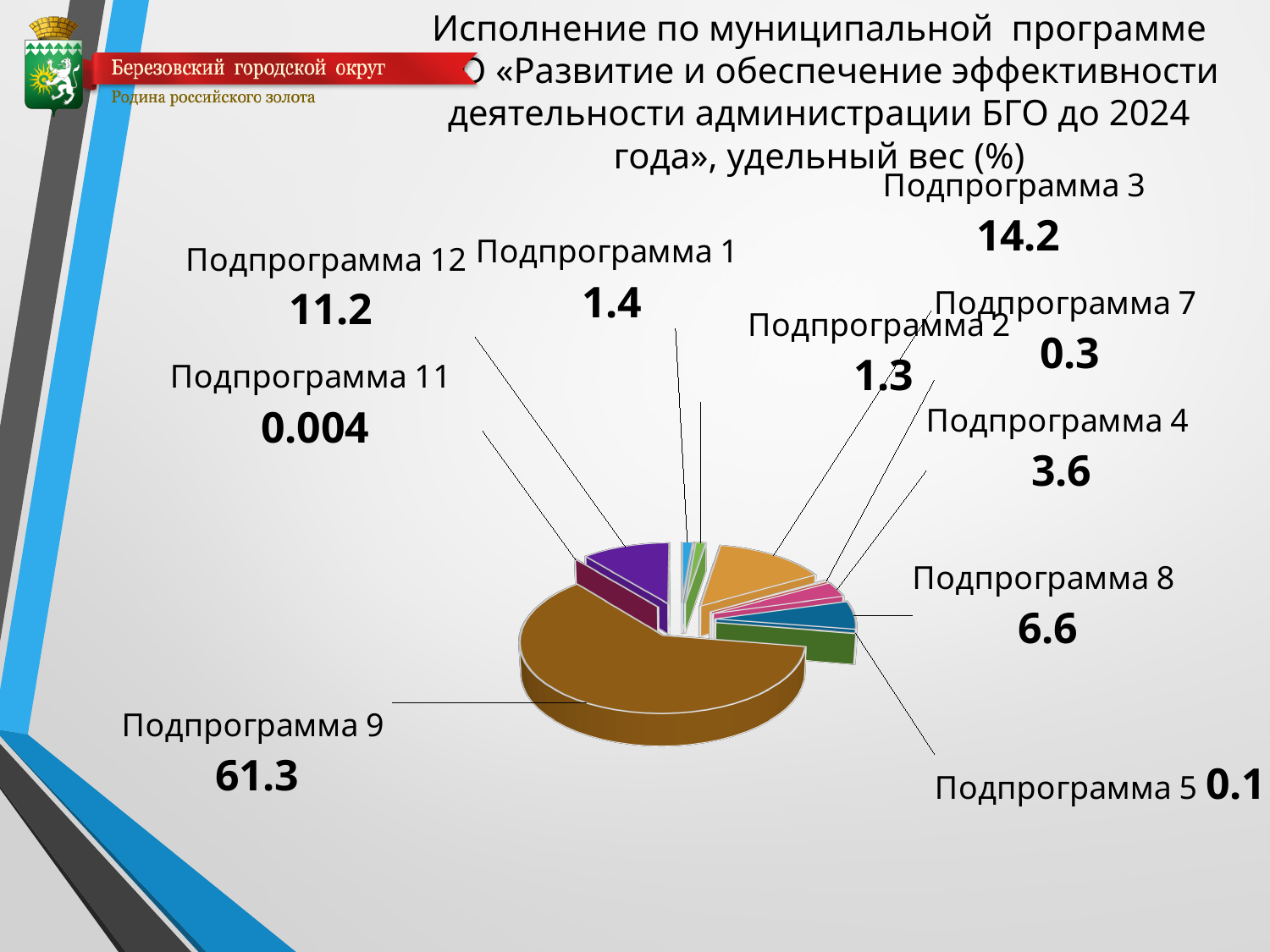
What is the value shown for Подпрограмма 9? 61.3 Which subprogram has the largest share of the pie? Подпрограмма 9 What is the value shown for Подпрограмма 8? 6.6 What is the value shown for Подпрограмма 3? 14.2 What is the difference between the values for Подпрограмма 8 and Подпрограмма 4? 3 What is the difference between the values for Подпрограмма 9 and Подпрограмма 3? 47.1 Which is larger, the value for Подпрограмма 12 or the value for Подпрограмма 8? Подпрограмма 12 What is the value shown for Подпрограмма 11? 0.004 How many subprograms are shown in the pie chart? 10 What kind of chart is shown on the slide? Pie chart Which subprogram has the smallest share of the pie? Подпрограмма 11 What is the value shown for Подпрограмма 12? 11.2